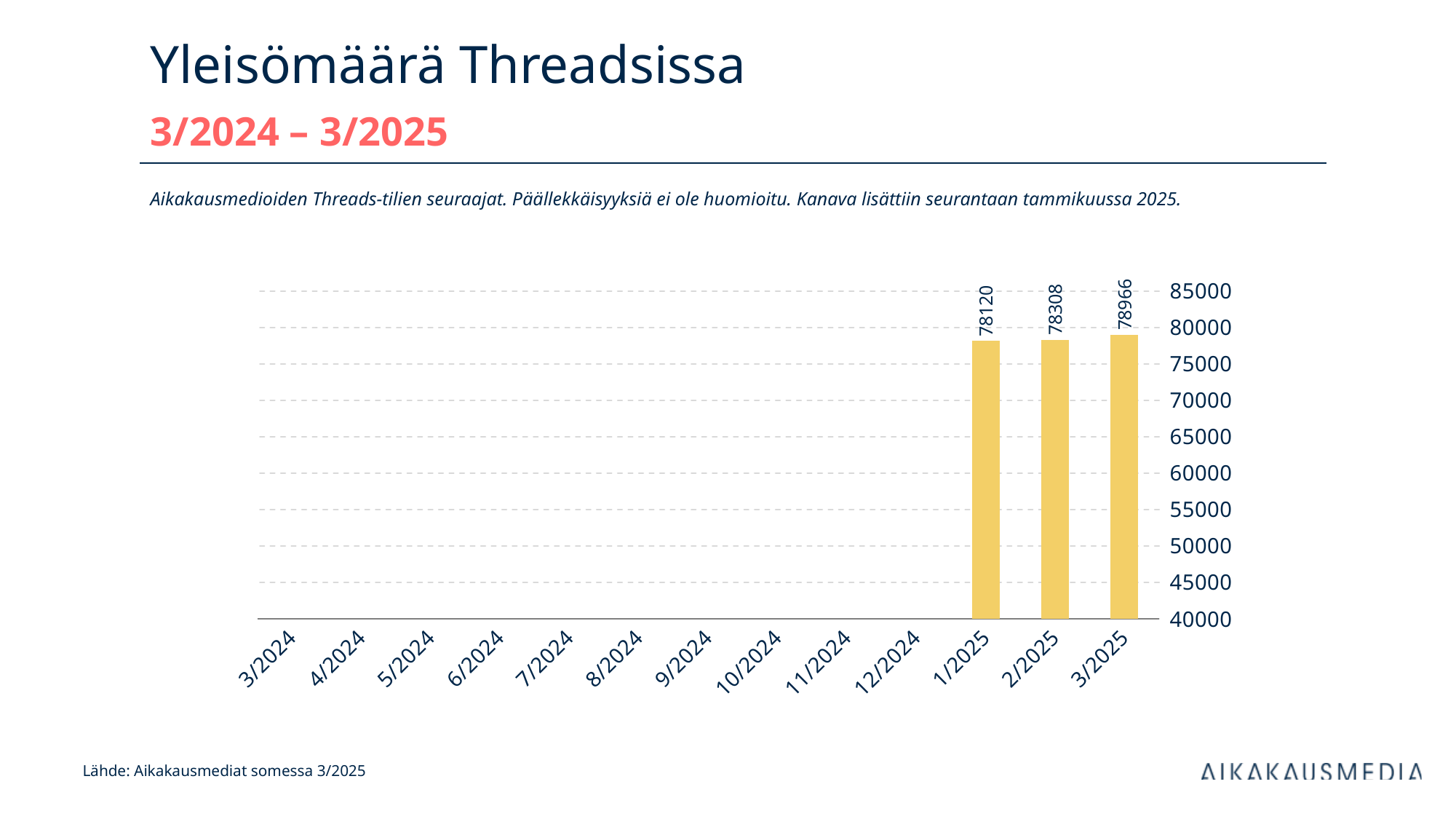
Among the months with bars, which has the lowest value? 1/2025 How many months have a bar plotted? 3 Is the value for 3/2025 greater or less than 80000? less Which month has the highest value? 3/2025 What is the difference between the values for 2/2025 and 1/2025? 188 How many months are shown on the x axis? 13 What is the difference between the values for 3/2025 and 1/2025? 846 What kind of chart is shown? bar chart What is the value for 3/2025? 78966 What is the value for 2/2025? 78308 Do the values rise or fall from 1/2025 to 3/2025? rise What is the value for 1/2025? 78120